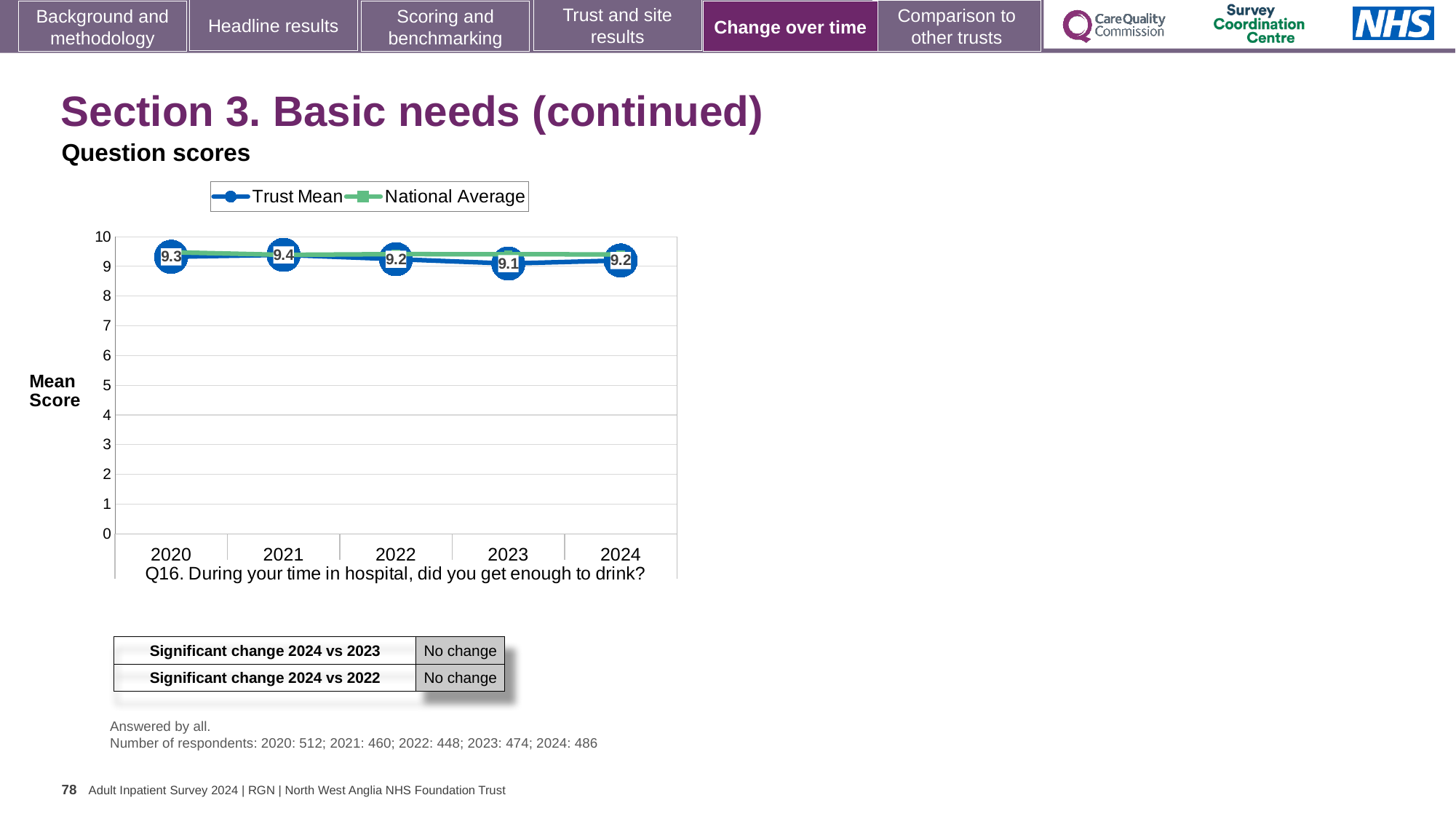
Does the Trust Mean rise or fall from 2021 to 2023? fall Is the National Average value for 2024 greater or less than 9? greater Which year has the larger Trust Mean, 2020 or 2023? 2020 In which year is the Trust Mean highest? 2021 In which year is the Trust Mean lowest? 2023 What is the Trust Mean score for 2024? 9.2 How many series does the legend list? 2 What is the Trust Mean score for 2021? 9.4 What is the difference between the Trust Mean in 2021 and in 2023? 0.3 What kind of chart is shown? line chart What is the Trust Mean score for 2023? 9.1 How many years are plotted on the x axis? 5